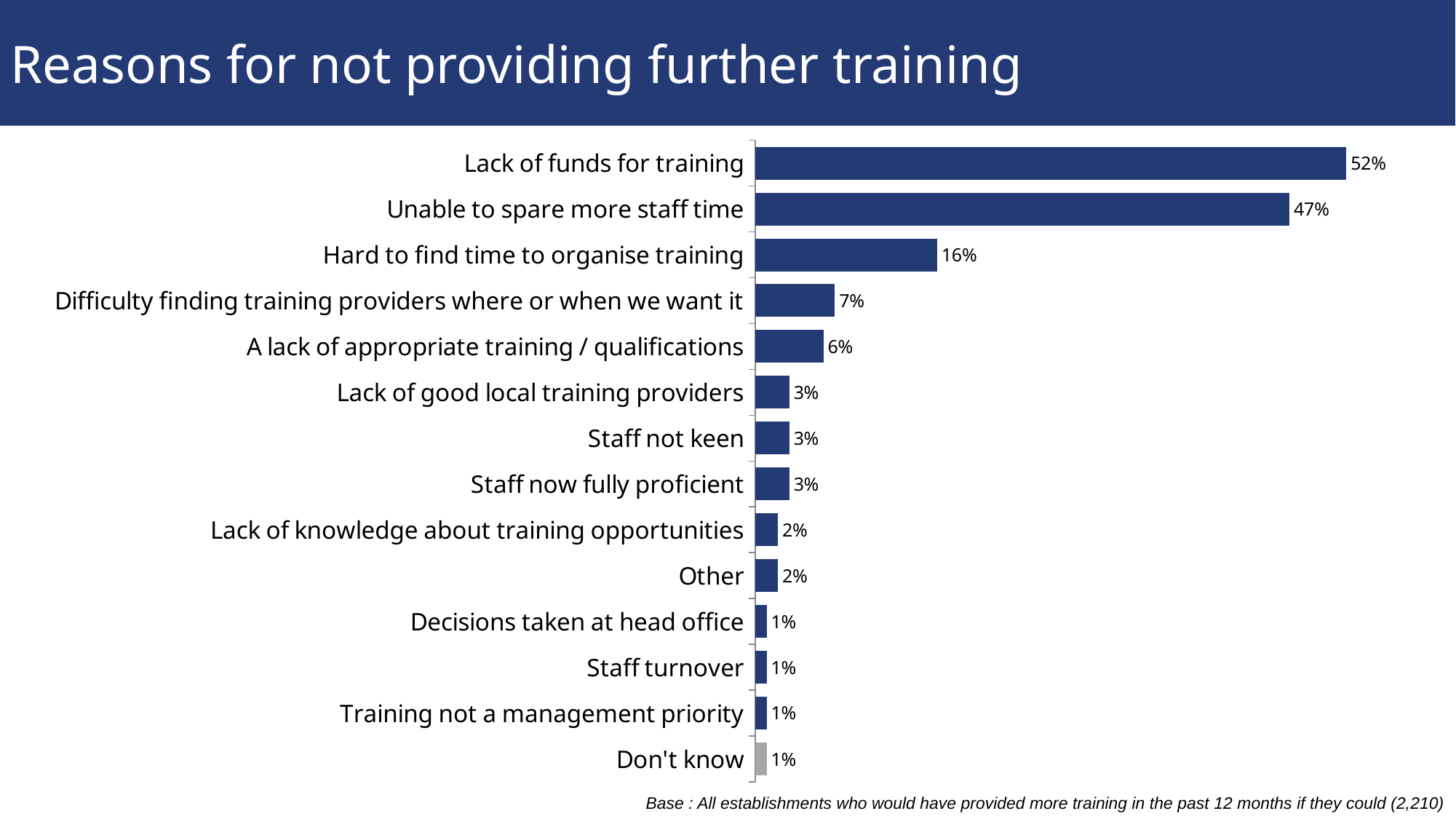
How many reasons (categories) are shown in the chart? 14 What is the value for 'Staff turnover'? 1% What percentage is shown for 'Difficulty finding training providers where or when we want it'? 7% Which reason has the highest percentage? Lack of funds for training What is the base size stated below the chart? 2,210 What is the difference between 'Hard to find time to organise training' and 'A lack of appropriate training / qualifications'? 10% Which bar is shown in a different colour (grey) from the others? Don't know What is the value for 'Hard to find time to organise training'? 16% What percentage of establishments cited 'Lack of funds for training' as a reason for not providing further training? 52% What is the difference in percentage points between 'Lack of funds for training' and 'Unable to spare more staff time'? 5 Which is larger: 'Unable to spare more staff time' or 'Hard to find time to organise training'? Unable to spare more staff time What type of chart is shown on the slide? Bar chart